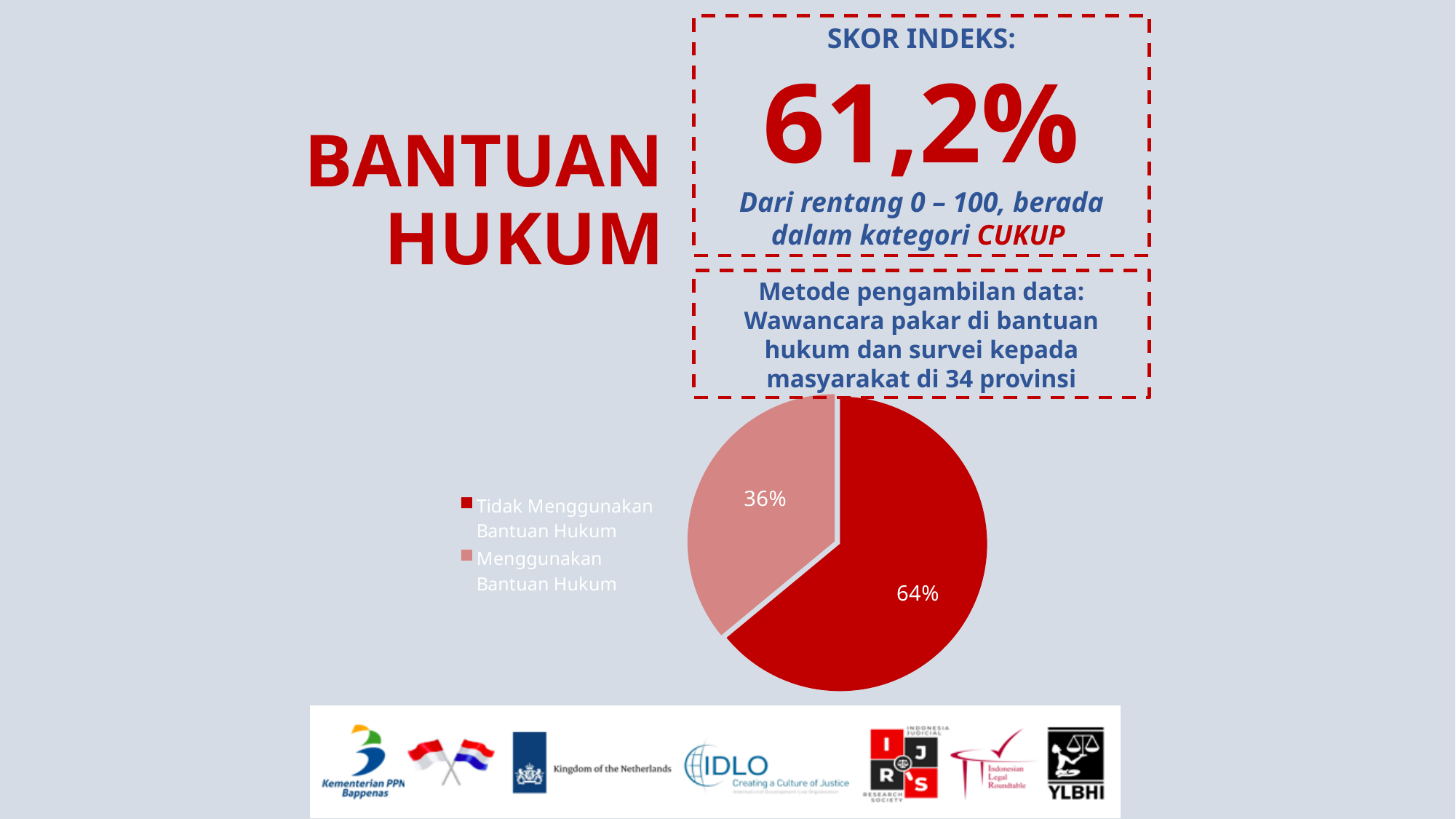
What share of the pie is labelled "Menggunakan Bantuan Hukum"? 36% What colour is the "Menggunakan Bantuan Hukum" slice in the pie chart? light pink What kind of chart is shown on the slide? pie chart Which is larger: the "Menggunakan Bantuan Hukum" slice or the "Tidak Menggunakan Bantuan Hukum" slice? Tidak Menggunakan Bantuan Hukum How many slices does the pie chart have? 2 Which slice of the pie is the smallest? Menggunakan Bantuan Hukum What share of the pie is labelled "Tidak Menggunakan Bantuan Hukum"? 64% Which slice of the pie is the largest? Tidak Menggunakan Bantuan Hukum What is the difference in percentage points between the "Tidak Menggunakan Bantuan Hukum" slice and the "Menggunakan Bantuan Hukum" slice? 28 percentage points On which side of the pie chart is the legend placed? left How many entries does the legend of the pie chart list? 2